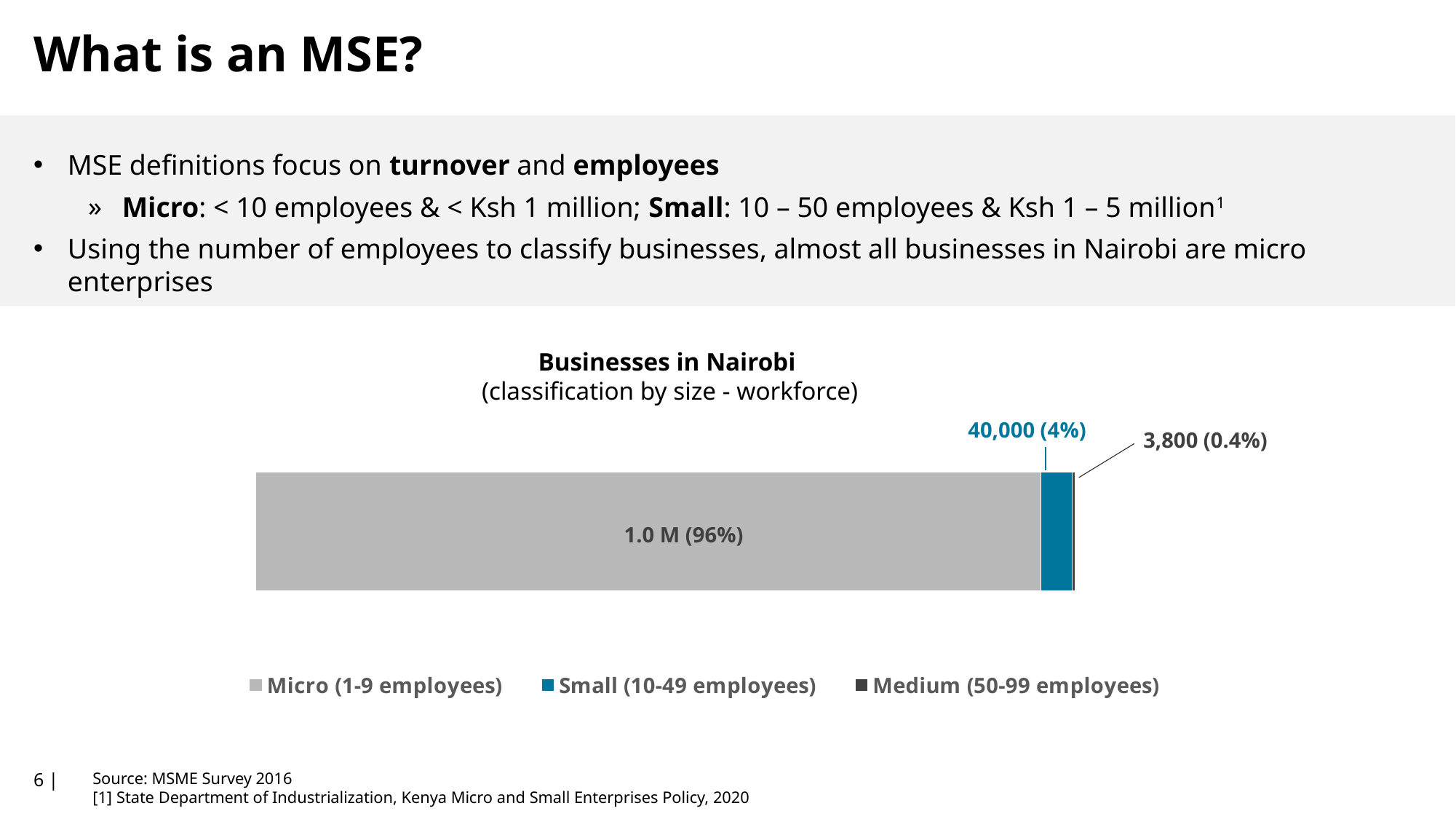
What is the difference between the number of Small businesses and the number of Medium businesses? 36,200 Which is larger, the number of Small businesses or the number of Medium businesses? Small (10-49 employees) What value is shown for Medium (50-99 employees)? 3,800 (0.4%) What share of businesses in Nairobi are Micro (1-9 employees)? 96% What value is shown for Small (10-49 employees)? 40,000 (4%) How many series does the chart legend list? 3 What kind of chart is shown on the slide? bar chart Which business size category has the largest number of businesses? Micro (1-9 employees) What value is shown for Micro (1-9 employees)? 1.0 M (96%) Which business size category has the smallest number of businesses? Medium (50-99 employees) Which colour represents Small (10-49 employees) in the chart? blue What is the title of the chart? Businesses in Nairobi (classification by size - workforce)